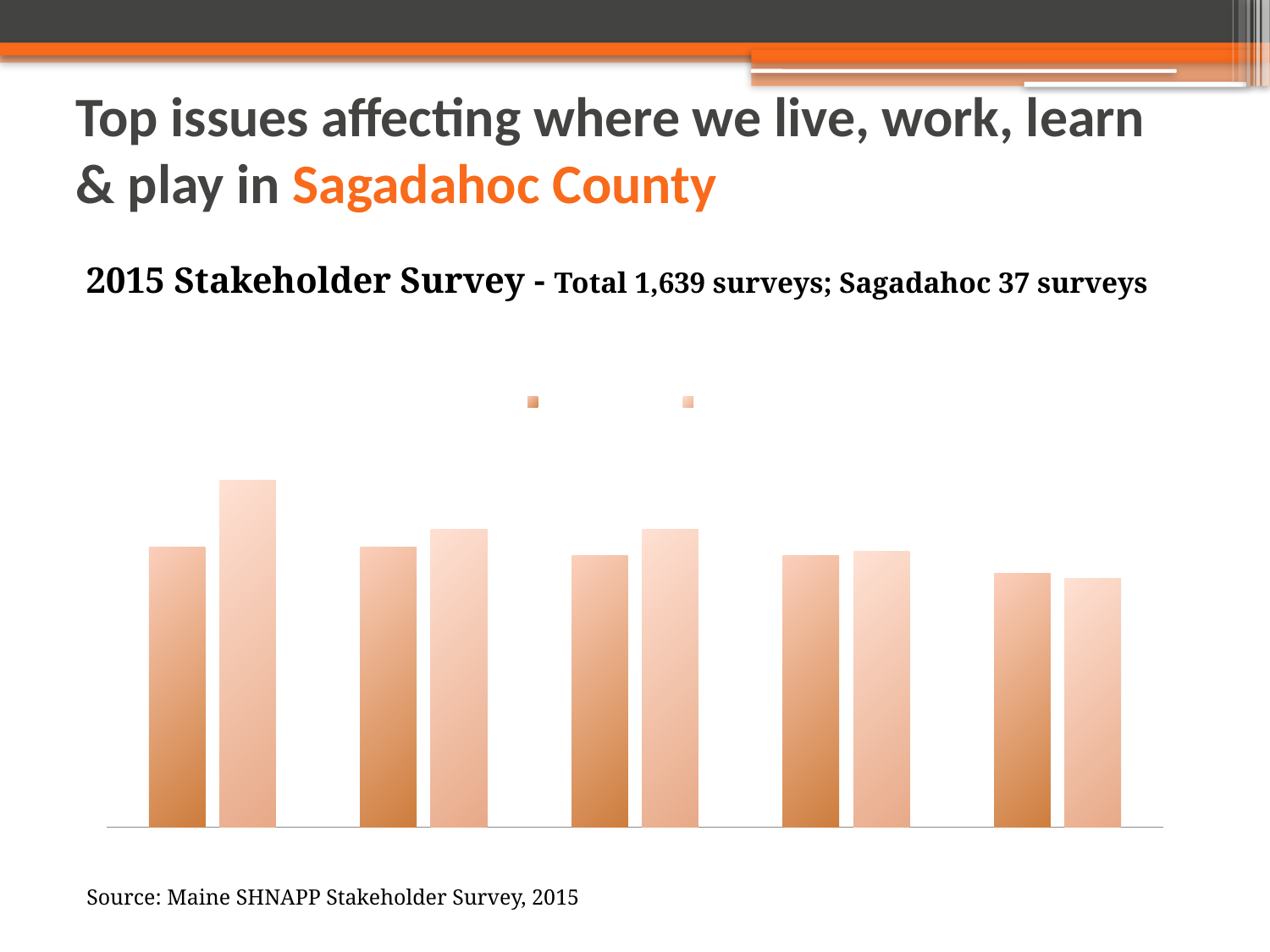
Do the values of the darker series generally rise or fall from left to right along the x axis? Fall Which bar is the tallest on the chart? The second bar from the left (the lighter bar in the first group) What source is cited below the chart? Maine SHNAPP Stakeholder Survey, 2015 How many bars are plotted in total on the chart? 10 How many groups of bars are plotted along the x axis? 5 What kind of chart is shown on the slide? Bar chart In the rightmost group, which bar is taller: the darker bar or the lighter bar? The darker bar What colours are used for the two series in the chart? Two shades of orange (a darker and a lighter orange) Do the values of the lighter series generally rise or fall from left to right along the x axis? Fall In the leftmost group, which bar is taller: the darker bar or the lighter bar? The lighter bar How many series does the chart's legend list? 2 Which bar is the shortest on the chart? The rightmost bar (the lighter bar in the last group)